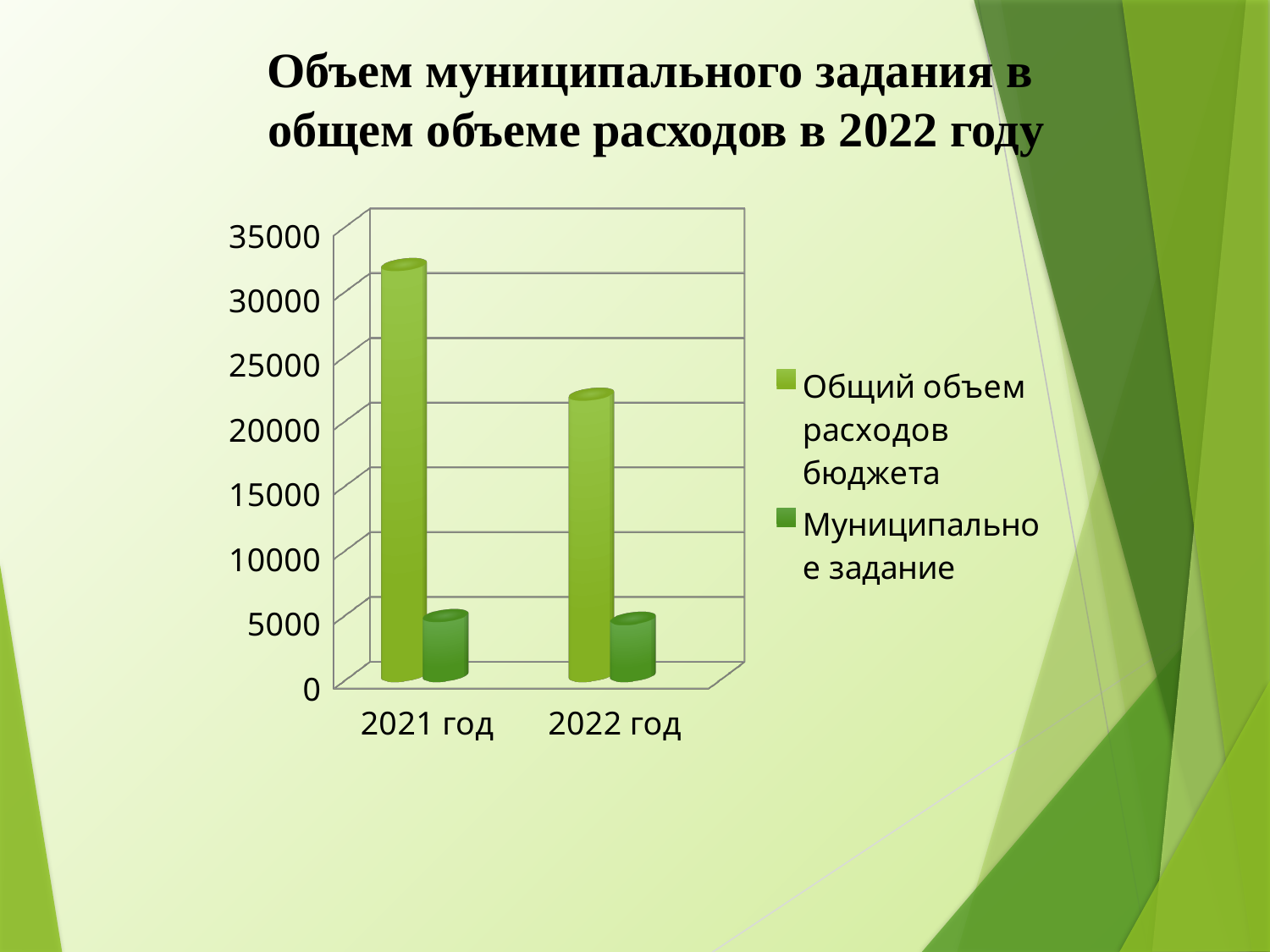
Does the value for Общий объем расходов бюджета rise or fall from 2021 год to 2022 год? fall Is the value for Общий объем расходов бюджета in 2022 год greater or less than 25000? less How many categories are shown on the x axis? 2 What is the title of the chart? Объем муниципального задания в общем объеме расходов в 2022 году Is the value for Общий объем расходов бюджета in 2021 год greater or less than 30000? greater How many series does the legend list? 2 Which series is listed first in the legend? Общий объем расходов бюджета Is the value for Муниципальное задание in 2022 год greater or less than 10000? less What type of chart is shown on the slide? bar chart Which year has the larger value for Общий объем расходов бюджета, 2021 год or 2022 год? 2021 год